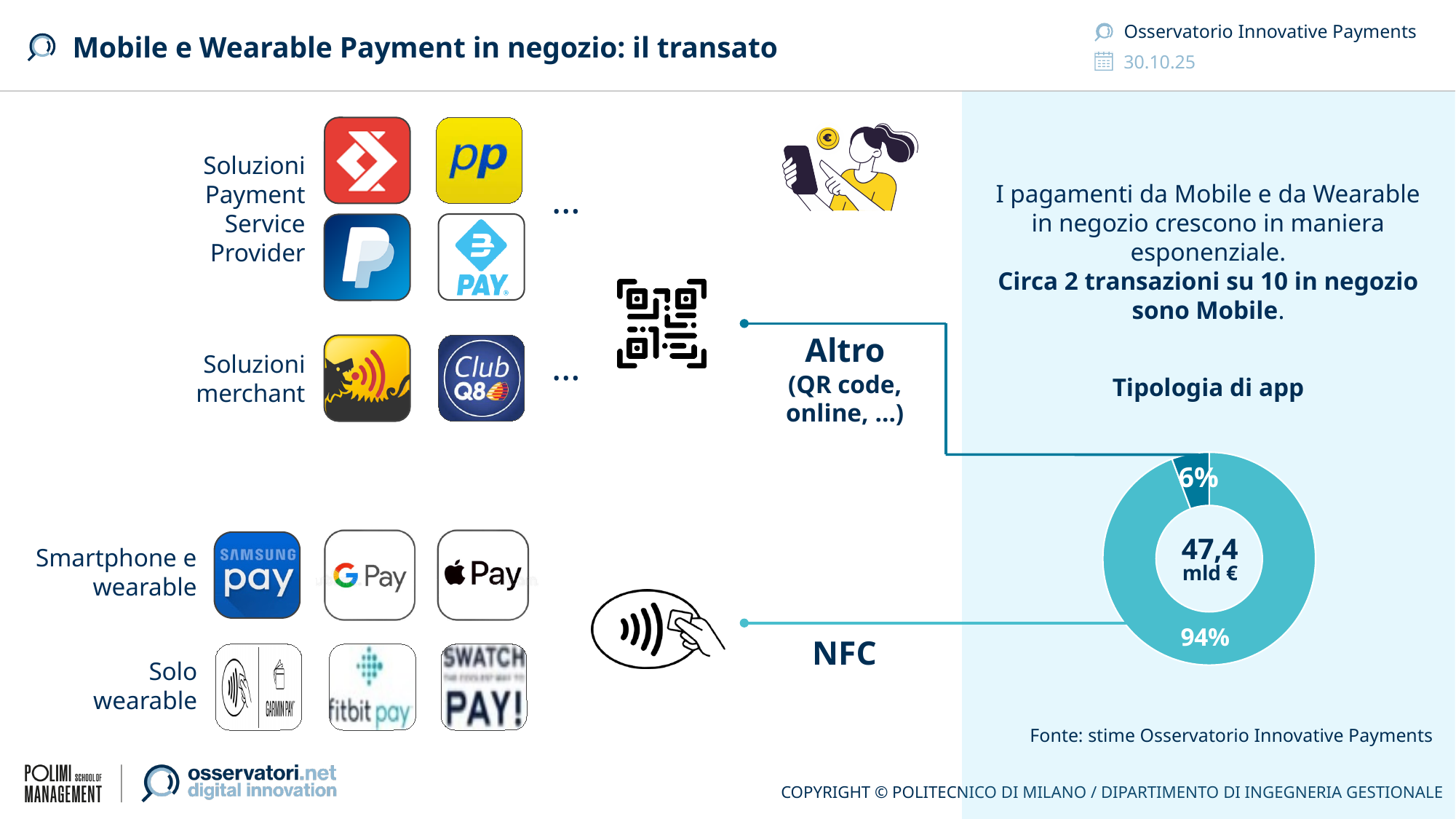
What kind of chart is "Tipologia di app"? Donut (pie) chart In the "Tipologia di app" chart, what is the difference in percentage points between NFC and Altro? 88 percentage points Which category has the smallest slice in the "Tipologia di app" chart? Altro (QR code, online, ...) What share of the "Tipologia di app" donut chart is NFC? 94% What total value is shown in the centre of the "Tipologia di app" donut chart? 47,4 mld € Is the NFC share in the "Tipologia di app" chart greater or less than 50%? greater What share of the "Tipologia di app" donut chart is Altro (QR code, online, ...)? 6% How many slices does the "Tipologia di app" chart have? 2 What is the title of the donut chart on the slide? Tipologia di app In the "Tipologia di app" chart, which is larger: NFC or Altro? NFC Which category has the largest slice in the "Tipologia di app" chart? NFC